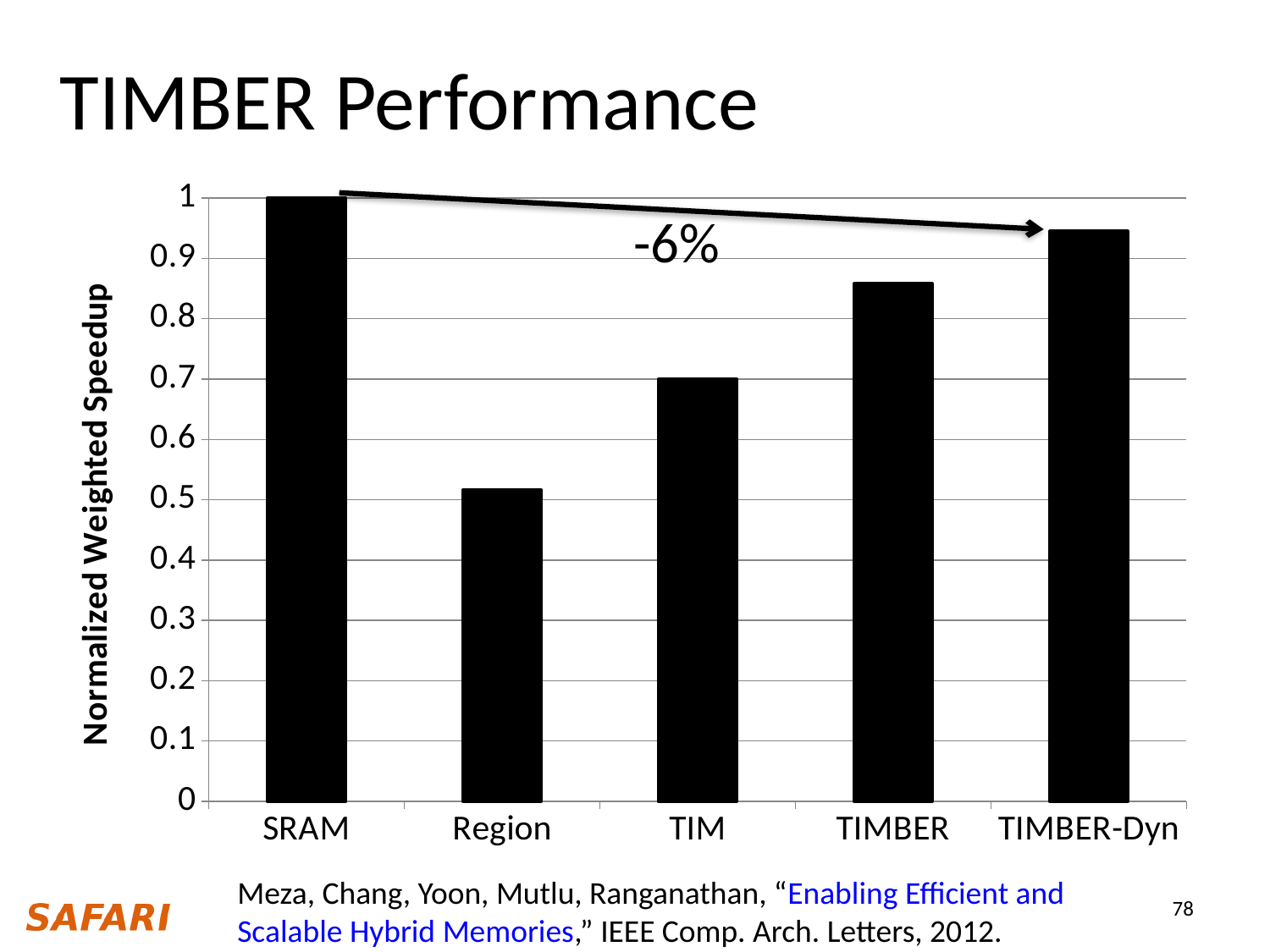
Is the value for TIMBER-Dyn greater or less than 0.9? greater How many categories are shown on the x axis of the chart? 5 Which category has the highest normalized weighted speedup? SRAM Which has a higher normalized weighted speedup, TIM or TIMBER? TIMBER Is the value for Region greater or less than 0.6? less What percentage is written next to the arrow from SRAM to TIMBER-Dyn? -6% Which category has the lowest normalized weighted speedup? Region What kind of chart is shown on the slide? bar chart Which has a higher normalized weighted speedup, Region or TIMBER-Dyn? TIMBER-Dyn Is the value for TIMBER greater or less than 0.8? greater What is the normalized weighted speedup for SRAM? 1 What is the label of the y axis? Normalized Weighted Speedup